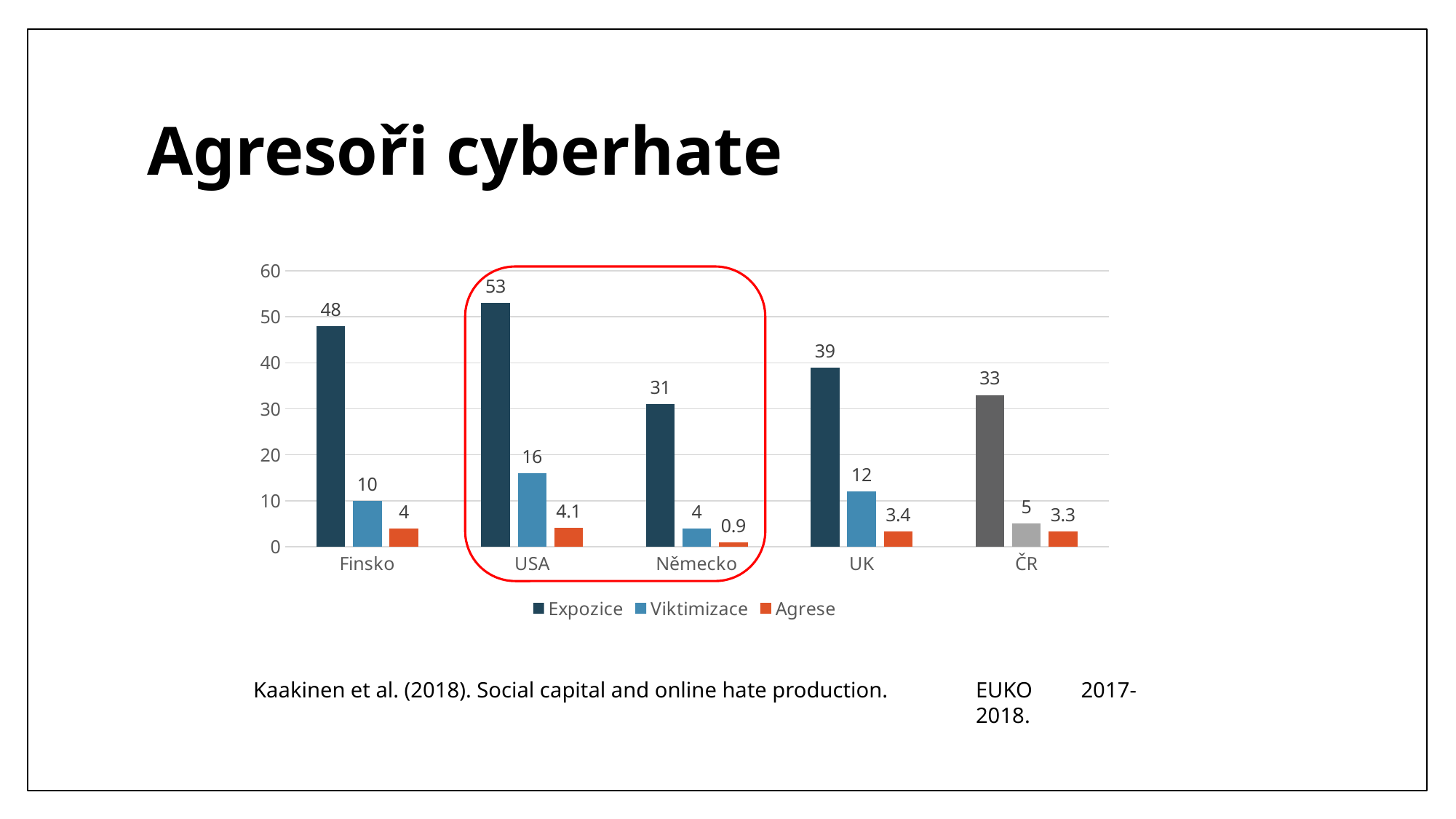
What is the Agrese value for ČR? 3.3 How many countries are shown on the x axis? 5 How many series does the legend list? 3 What is the difference between the Expozice values for USA and Finsko? 5 Which country has the lowest Agrese value? Německo What is the Expozice value for USA? 53 Which is larger, the Viktimizace value for Finsko or for UK? UK What is the Viktimizace value for UK? 12 What is the Agrese value for Německo? 0.9 Which two countries are enclosed by the red outline on the chart? USA and Německo What kind of chart is shown on the slide? Bar chart Which country has the highest Expozice value? USA